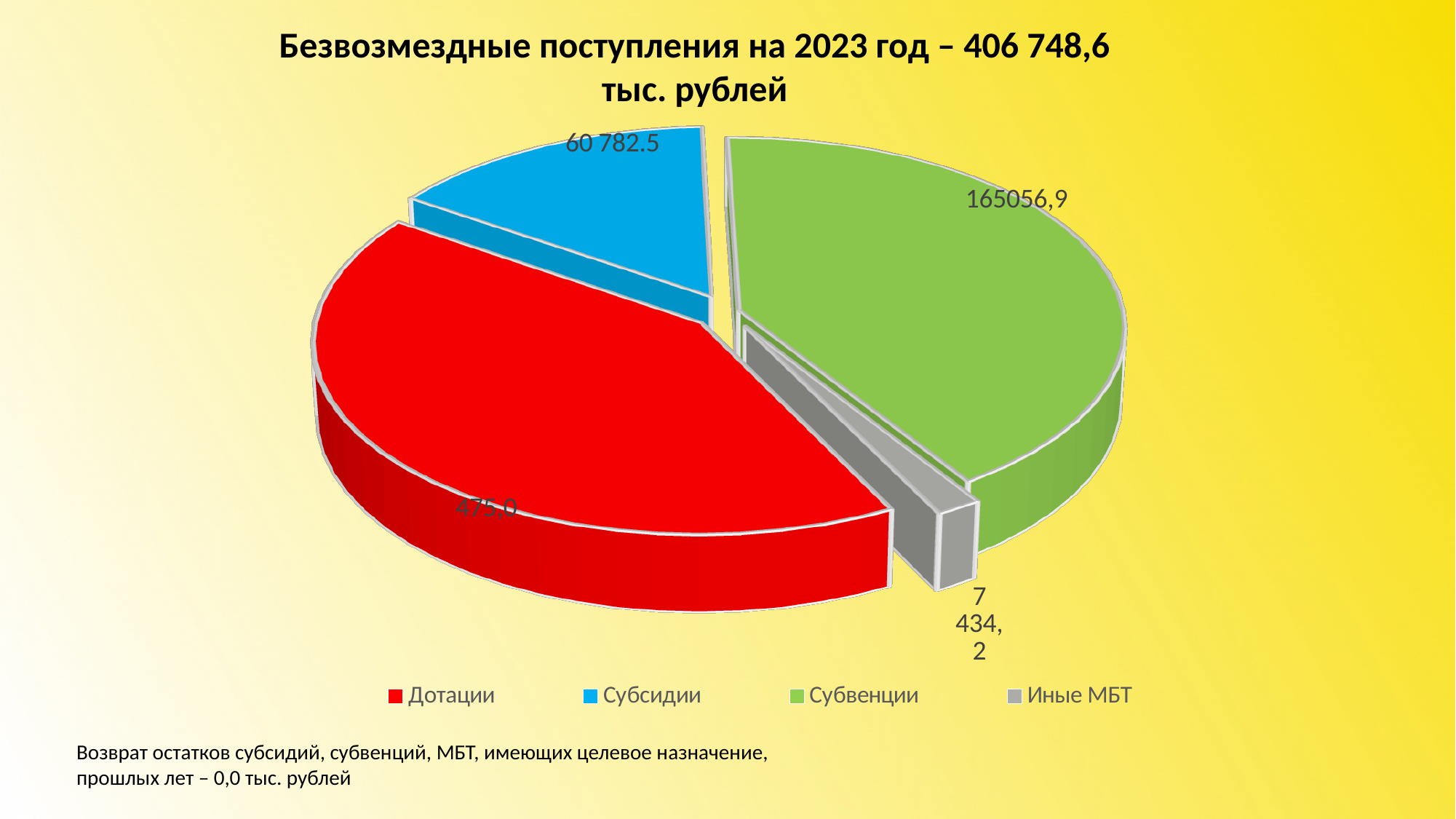
What is the value shown for Субвенции? 165056,9 How many slices does the pie chart have? 4 Which category has the smallest slice of the pie? Иные МБТ What total amount is stated in the chart title? 406 748,6 тыс. рублей What colour represents Дотации in the chart? Red What kind of chart is shown on the slide? Pie chart Which is larger, Субсидии or Субвенции? Субвенции Which is larger, Иные МБТ or Субсидии? Субсидии What is the value shown for Субсидии? 60 782.5 How many entries does the legend list? 4 What is the value shown for Иные МБТ? 7 434,2 What is the difference between the values for Субвенции and Субсидии? 104 274,4